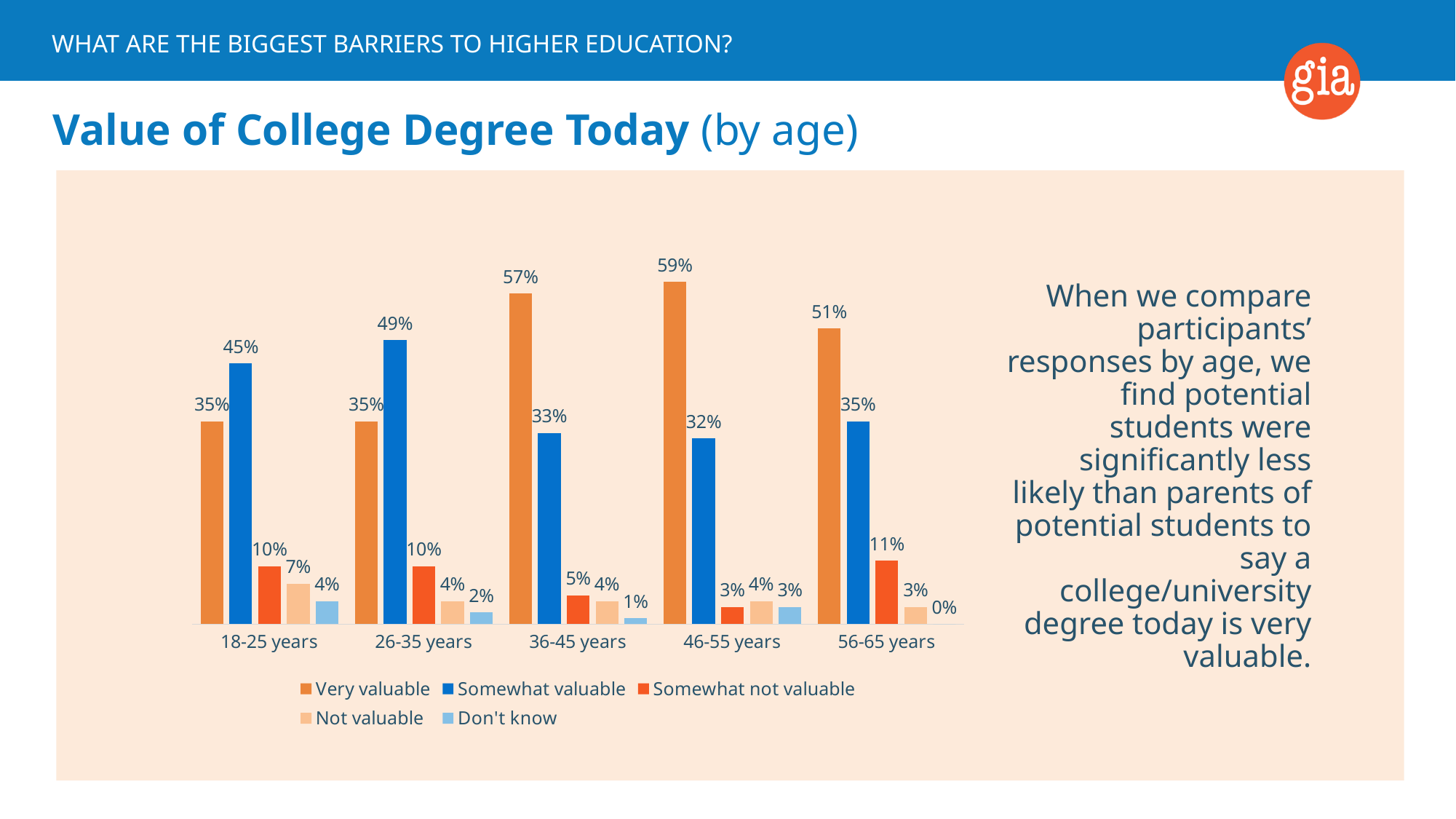
What is the value for Somewhat valuable in the 18-25 years group? 45% What colour represents the Somewhat valuable series? Blue What is the difference between the Very valuable values for 46-55 years and 18-25 years? 24% What is the Somewhat not valuable value for the 56-65 years group? 11% What is the Don't know value for the 56-65 years group? 0% How many series does the legend list? 5 What kind of chart is shown on the slide? Bar chart Which age group has the highest Very valuable value? 46-55 years How many age groups are shown on the x axis? 5 Which age group has the lowest Somewhat valuable value? 46-55 years What percentage of 36-45 year olds said a college degree is very valuable? 57% Which is larger for the 26-35 years group: Very valuable or Somewhat valuable? Somewhat valuable